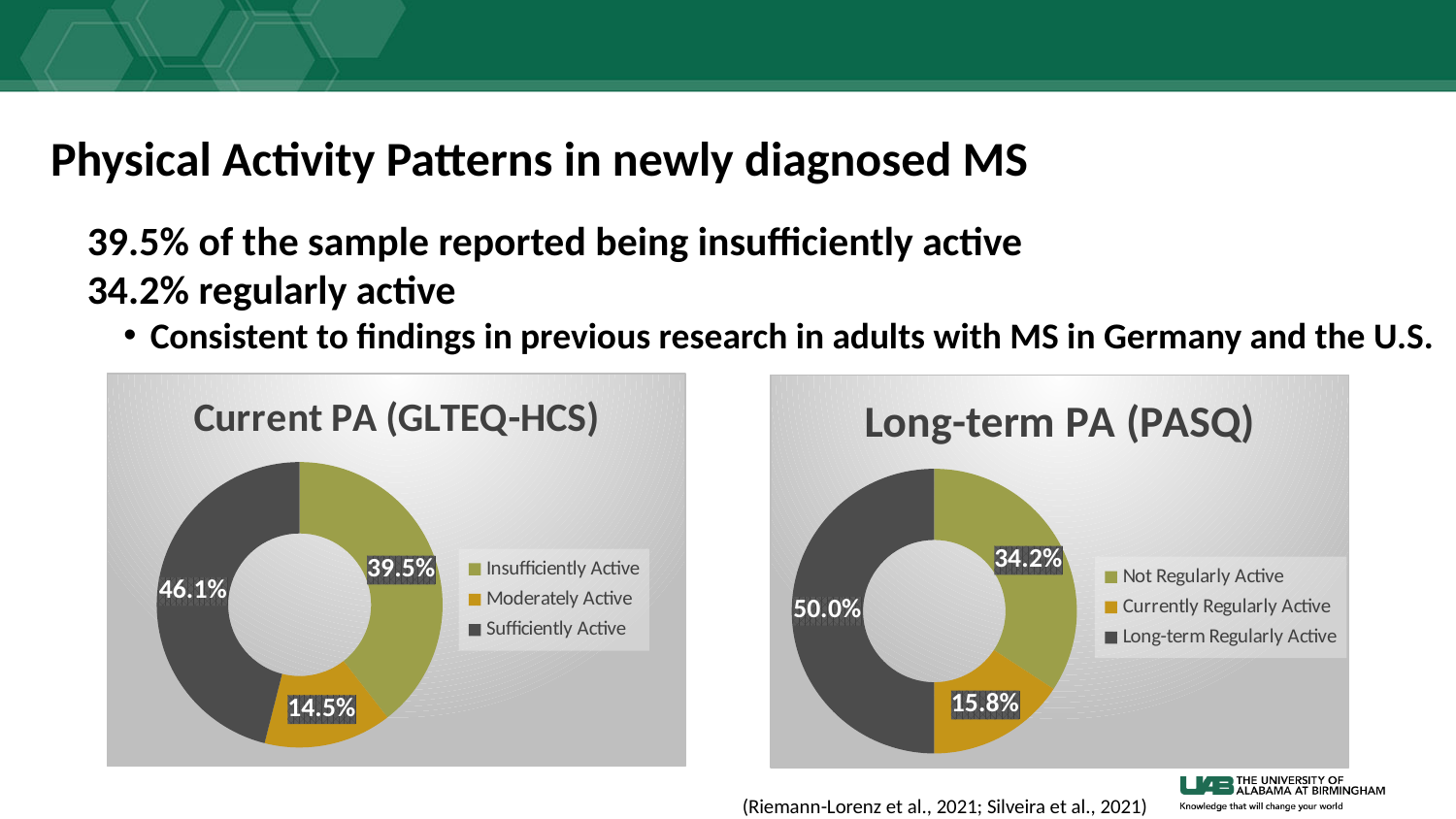
In the 'Long-term PA (PASQ)' chart, what percentage is shown for Currently Regularly Active? 15.8% In the 'Long-term PA (PASQ)' chart, what percentage is shown for Not Regularly Active? 34.2% What type of chart is the 'Current PA (GLTEQ-HCS)' chart? Doughnut chart In the 'Current PA (GLTEQ-HCS)' chart, what is the difference between the Sufficiently Active and Insufficiently Active percentages? 6.6% In the 'Long-term PA (PASQ)' chart, what is the difference between the Long-term Regularly Active and Not Regularly Active percentages? 15.8% In the 'Long-term PA (PASQ)' chart, what colour represents Long-term Regularly Active? Dark grey In the 'Current PA (GLTEQ-HCS)' chart, what percentage is shown for Sufficiently Active? 46.1% In the 'Current PA (GLTEQ-HCS)' chart, what percentage is shown for Moderately Active? 14.5% In the 'Current PA (GLTEQ-HCS)' chart, which is larger: Insufficiently Active or Moderately Active? Insufficiently Active In the 'Current PA (GLTEQ-HCS)' chart, which category has the largest share? Sufficiently Active In the 'Long-term PA (PASQ)' chart, which category has the smallest share? Currently Regularly Active How many categories does the 'Long-term PA (PASQ)' chart show? 3